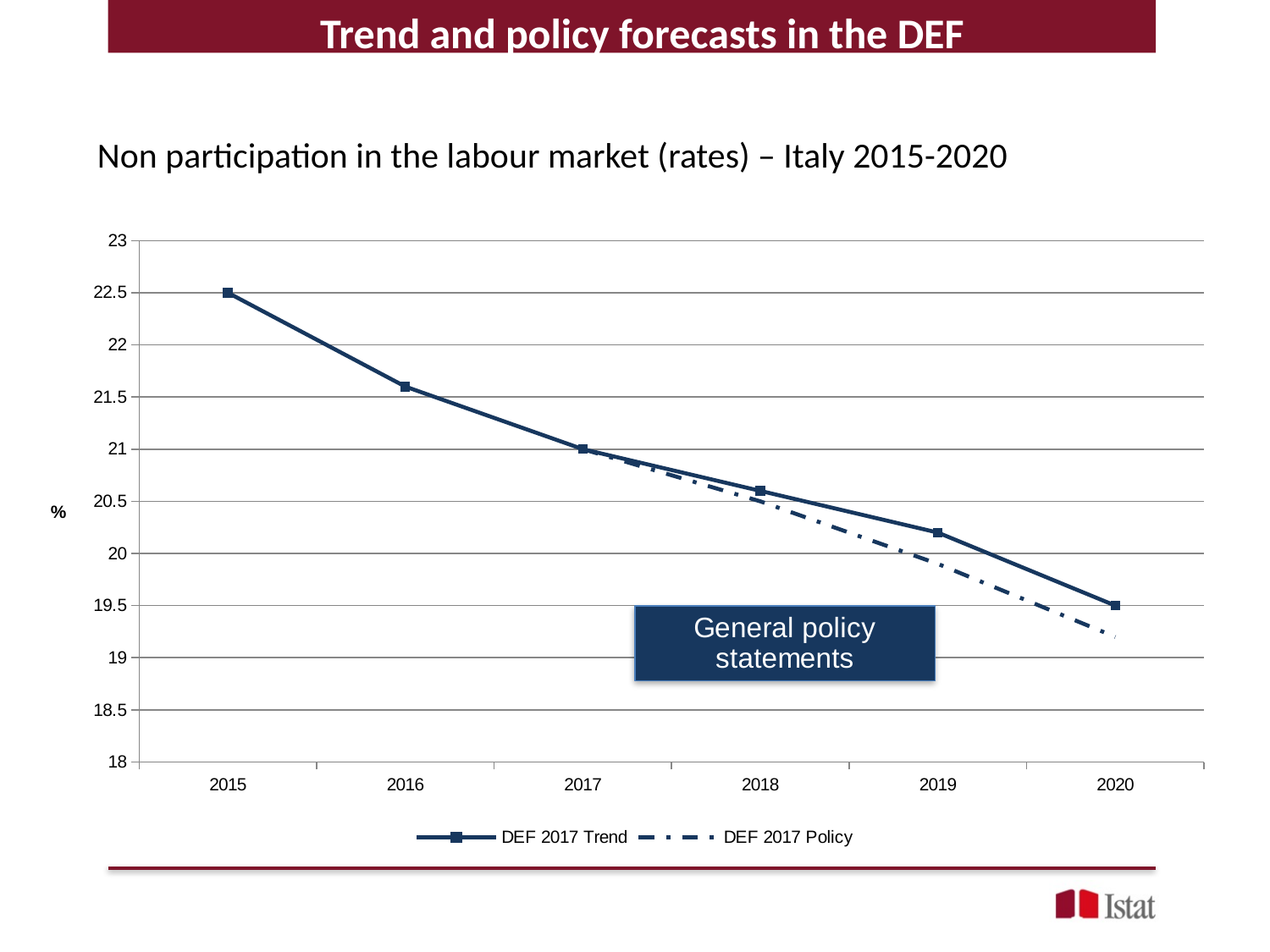
What is the DEF 2017 Trend value for 2017? 21 In 2020, which series has the higher value, DEF 2017 Trend or DEF 2017 Policy? DEF 2017 Trend How many series does the legend list? 2 What is the DEF 2017 Trend value for 2015? 22.5 By how much does the DEF 2017 Trend value fall from 2015 to 2020? 3 Do the DEF 2017 Trend values rise or fall from 2015 to 2020? fall How many years are shown on the x axis? 6 Which year has the highest DEF 2017 Trend value? 2015 What kind of chart is shown on the slide? line chart What is the DEF 2017 Trend value for 2020? 19.5 Which year has the lowest DEF 2017 Trend value? 2020 Is the DEF 2017 Trend value for 2019 greater or less than 20? greater